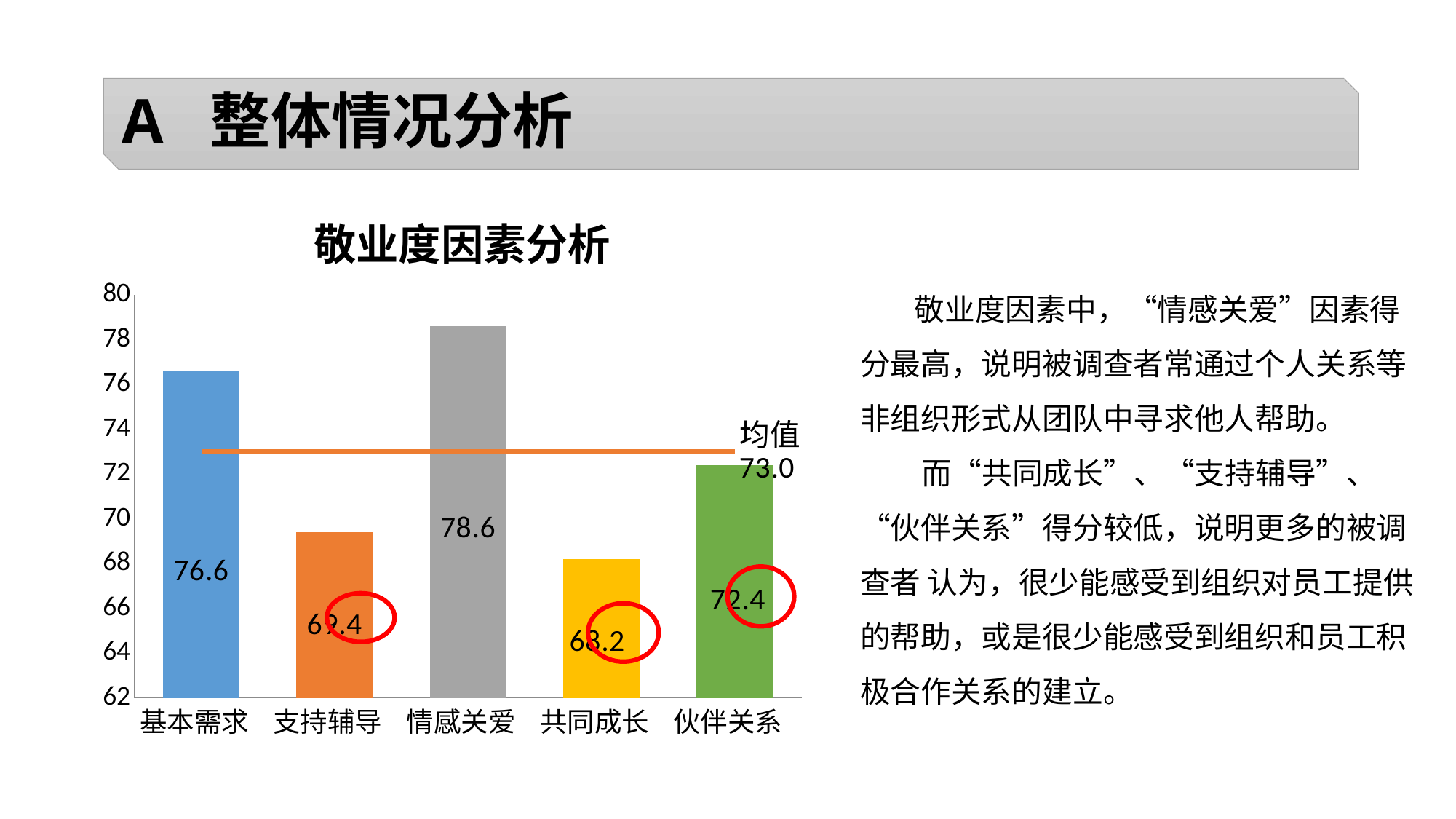
Which category has the highest value? 情感关爱 What is the value for 情感关爱? 78.6 What is the difference between the values for 情感关爱 and 基本需求? 2.0 What is the value for 伙伴关系? 72.4 Which category has the lowest value? 共同成长 What value is shown for the 均值 (mean) line? 73.0 What is the value for 基本需求? 76.6 What kind of chart is this? bar chart What is the value for 共同成长? 68.2 Is the value for 支持辅导 greater or less than 70? less How many categories are shown on the x axis? 5 Which is larger, the value for 基本需求 or the value for 伙伴关系? 基本需求